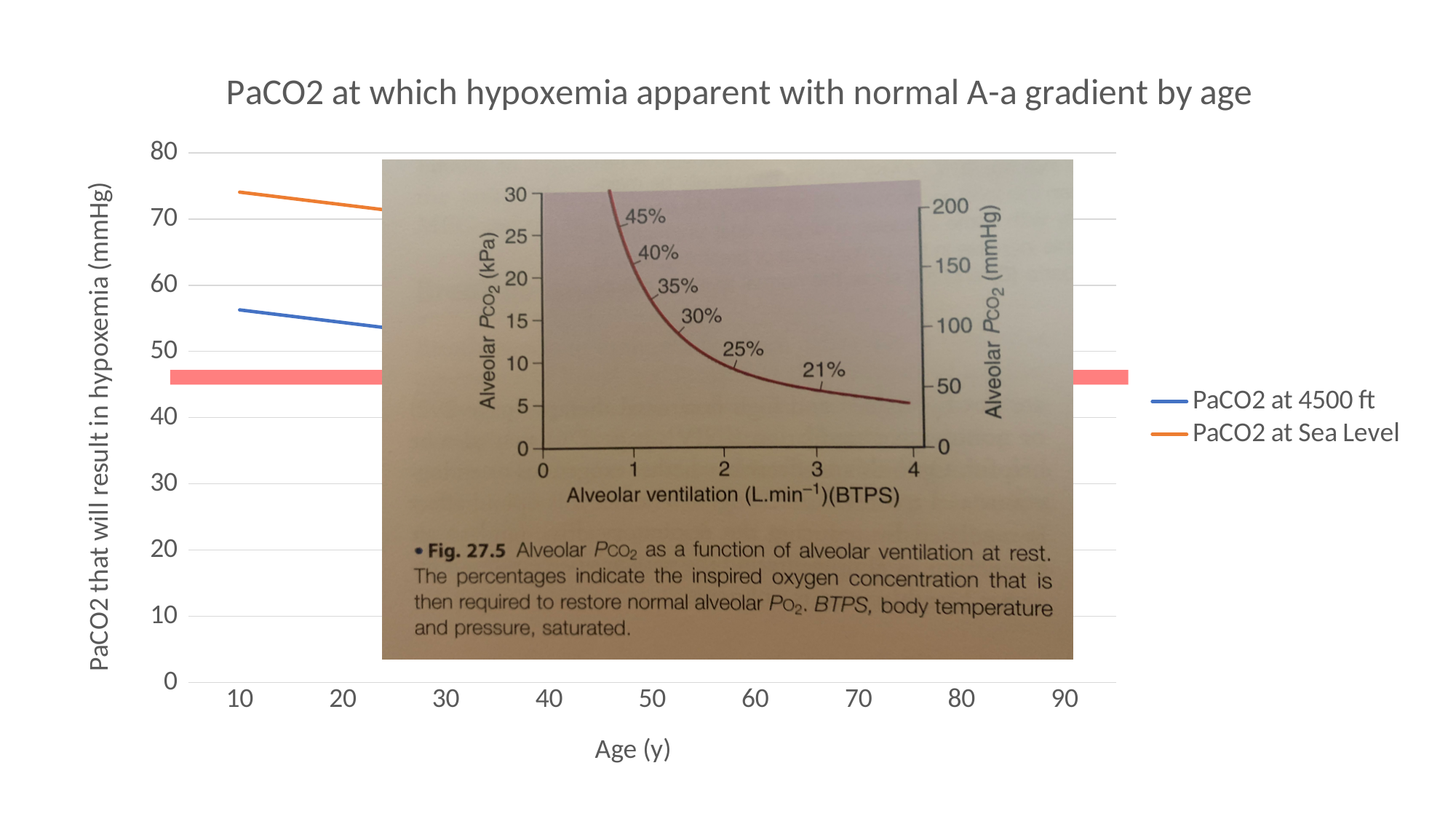
In the inset figure (Fig. 27.5), what is the highest value shown on the right-hand axis (Alveolar PCO2 in mmHg)? 200 In the main chart, is the value for PaCO2 at 4500 ft at age 10 greater or less than 50? greater In the inset figure (Fig. 27.5), how many inspired oxygen percentage labels are shown along the curve? 6 In the main chart, do the PaCO2 values rise or fall as age increases? fall What kind of chart is the main chart on the slide (PaCO2 at which hypoxemia apparent with normal A-a gradient by age)? line chart What is the title of the main chart on the slide? PaCO2 at which hypoxemia apparent with normal A-a gradient by age In the main chart, is the value for PaCO2 at Sea Level at age 10 greater or less than 70? greater In the main chart, which series has the higher value at age 10: PaCO2 at 4500 ft or PaCO2 at Sea Level? PaCO2 at Sea Level How many series does the legend of the main chart list? 2 In the inset figure (Fig. 27.5), does alveolar PCO2 rise or fall as alveolar ventilation increases? fall What are the two series named in the legend of the main chart? PaCO2 at 4500 ft and PaCO2 at Sea Level In the main chart, is the value for PaCO2 at 4500 ft at age 10 greater or less than 60? less